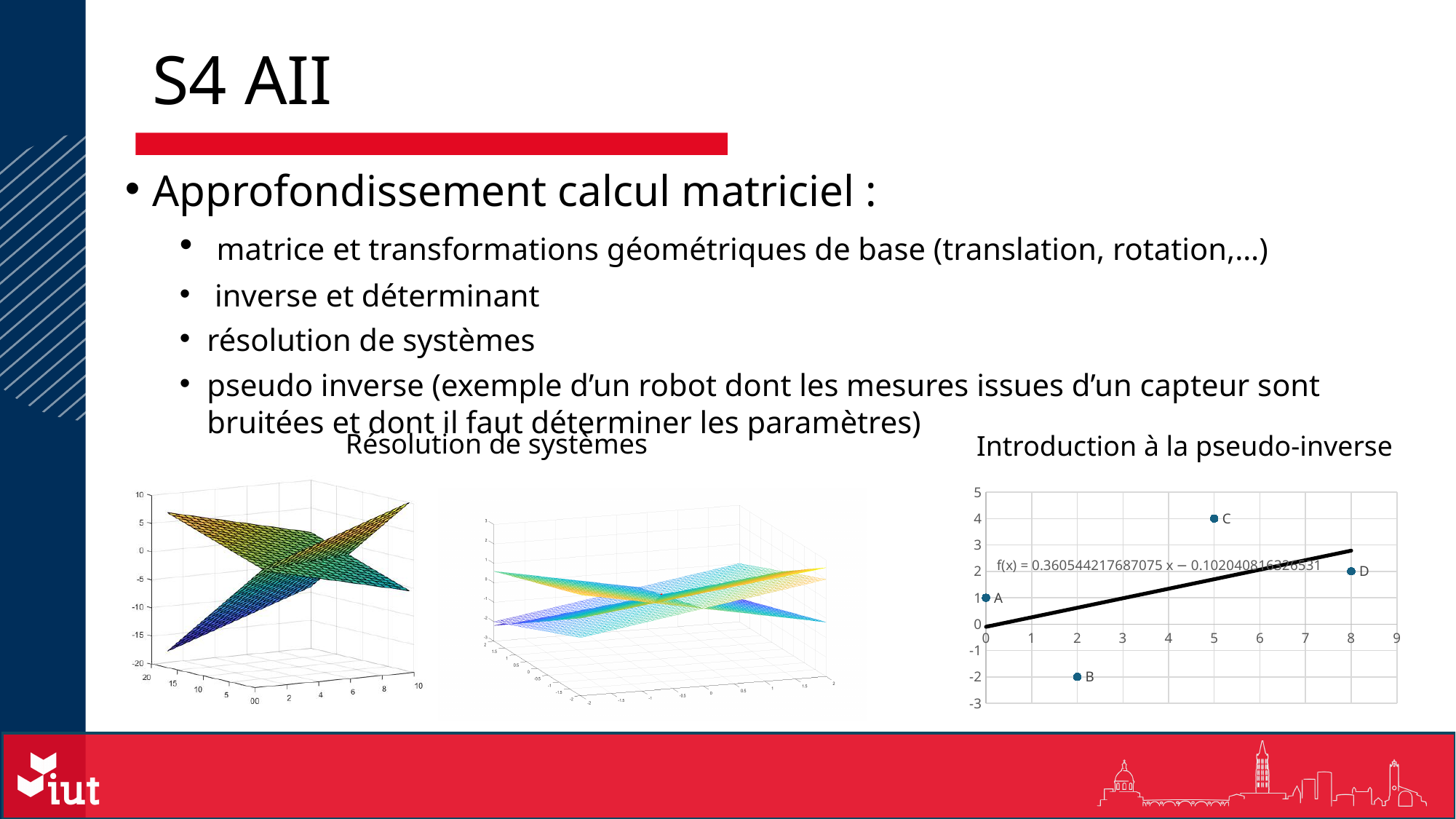
In the chart titled "Introduction à la pseudo-inverse", what is the y value of point C? 4 In the chart titled "Introduction à la pseudo-inverse", what is the difference between the y values of points C and D? 2 In the chart titled "Introduction à la pseudo-inverse", how many labelled data points are plotted? 4 In the chart titled "Introduction à la pseudo-inverse", what kind of chart is shown? scatter chart In the chart titled "Introduction à la pseudo-inverse", does the fitted line rise or fall as x increases? rise In the chart titled "Introduction à la pseudo-inverse", what is the y value of point B? -2 In the chart titled "Introduction à la pseudo-inverse", which point has a larger y value, C or D? C In the chart titled "Introduction à la pseudo-inverse", which point has the highest y value? C In the chart titled "Introduction à la pseudo-inverse", what equation is printed for the fitted line? f(x) = 0.360544217687075 x − 0.102040816326531 What is the title shown above the two 3D surface plots on the left of the slide? Résolution de systèmes In the chart titled "Introduction à la pseudo-inverse", what is the x value of point D? 8 In the chart titled "Introduction à la pseudo-inverse", which point has the lowest y value? B